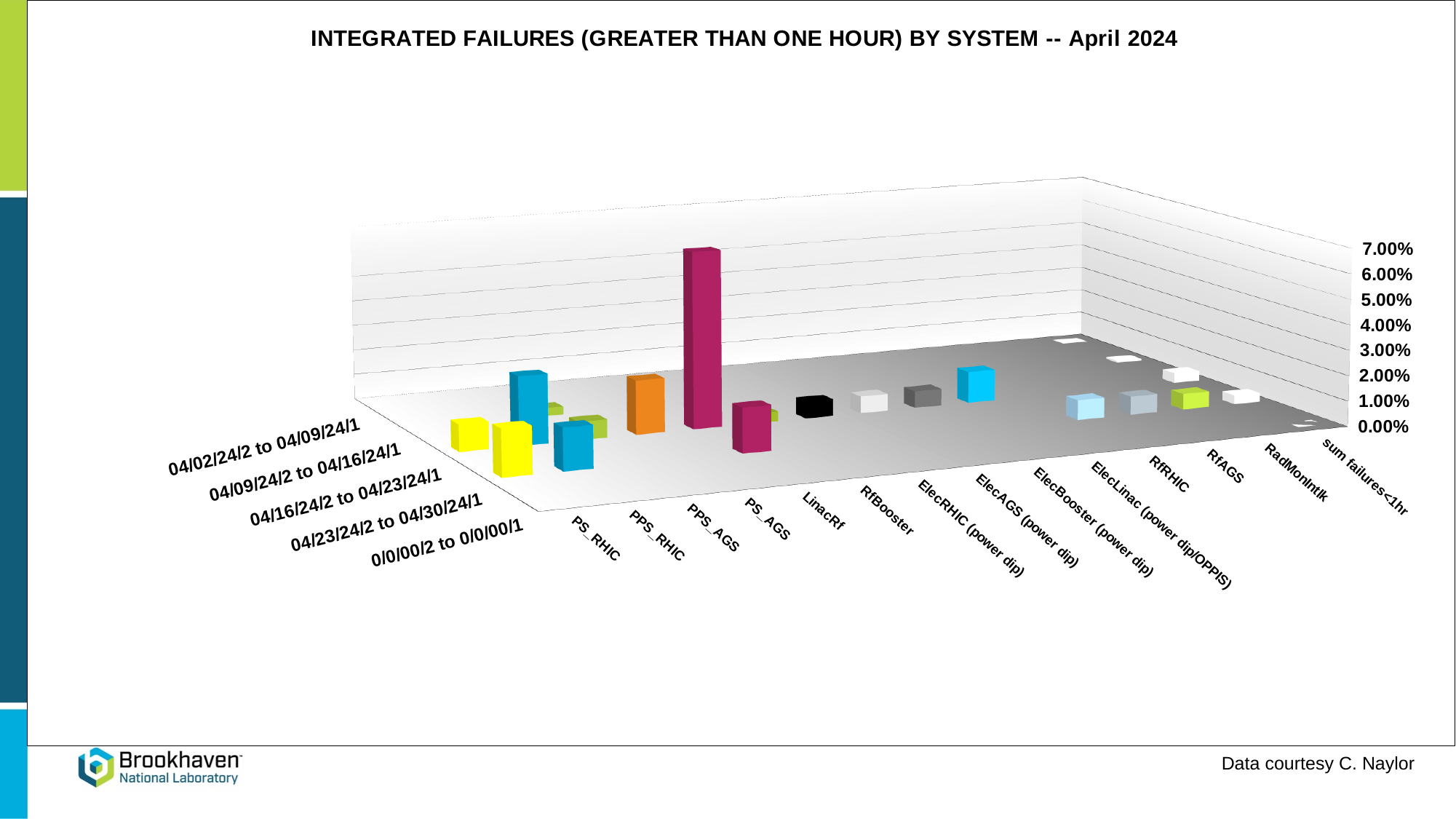
What is the highest value shown on the vertical axis? 7.00% What is the title of the chart? INTEGRATED FAILURES (GREATER THAN ONE HOUR) BY SYSTEM -- April 2024 Which system is listed first on the horizontal axis? PS_RHIC Which has the taller bar: PPS_AGS or PPS_RHIC? PPS_RHIC Which system has the tallest bar in the chart? LinacRf How many date ranges are shown along the depth axis of the chart? 5 What type of chart is shown on the slide? bar chart Which system is listed last on the horizontal axis? sum failures<1hr Is the tallest bar for PPS_AGS greater or less than 3.00%? less How many systems are listed along the horizontal axis of the chart? 14